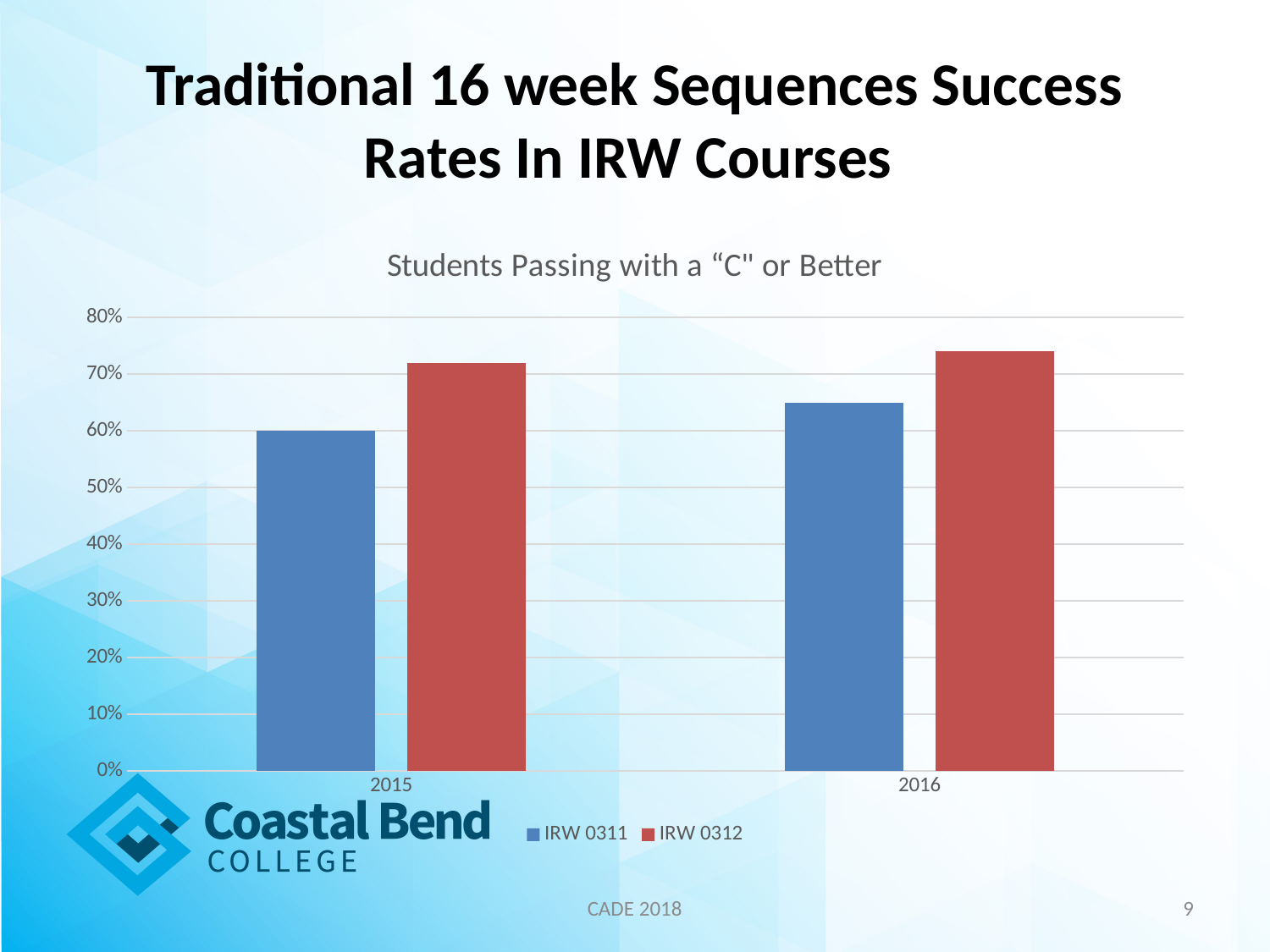
How many series does the legend list? 2 In 2016, which course has the higher success rate, IRW 0311 or IRW 0312? IRW 0312 Is the value for IRW 0312 in 2015 greater or less than 70%? greater Is the value for IRW 0311 in 2016 greater or less than 60%? greater How many years are shown on the x axis? 2 In 2015, which course has the higher success rate, IRW 0311 or IRW 0312? IRW 0312 What is the value for IRW 0311 in 2015? 60% Which bar is the lowest in the chart? IRW 0311 in 2015 Is the value for IRW 0312 in 2016 greater or less than 70%? greater Does the success rate for IRW 0311 rise or fall from 2015 to 2016? rise Which bar is the highest in the chart? IRW 0312 in 2016 What kind of chart is shown on the slide? bar chart